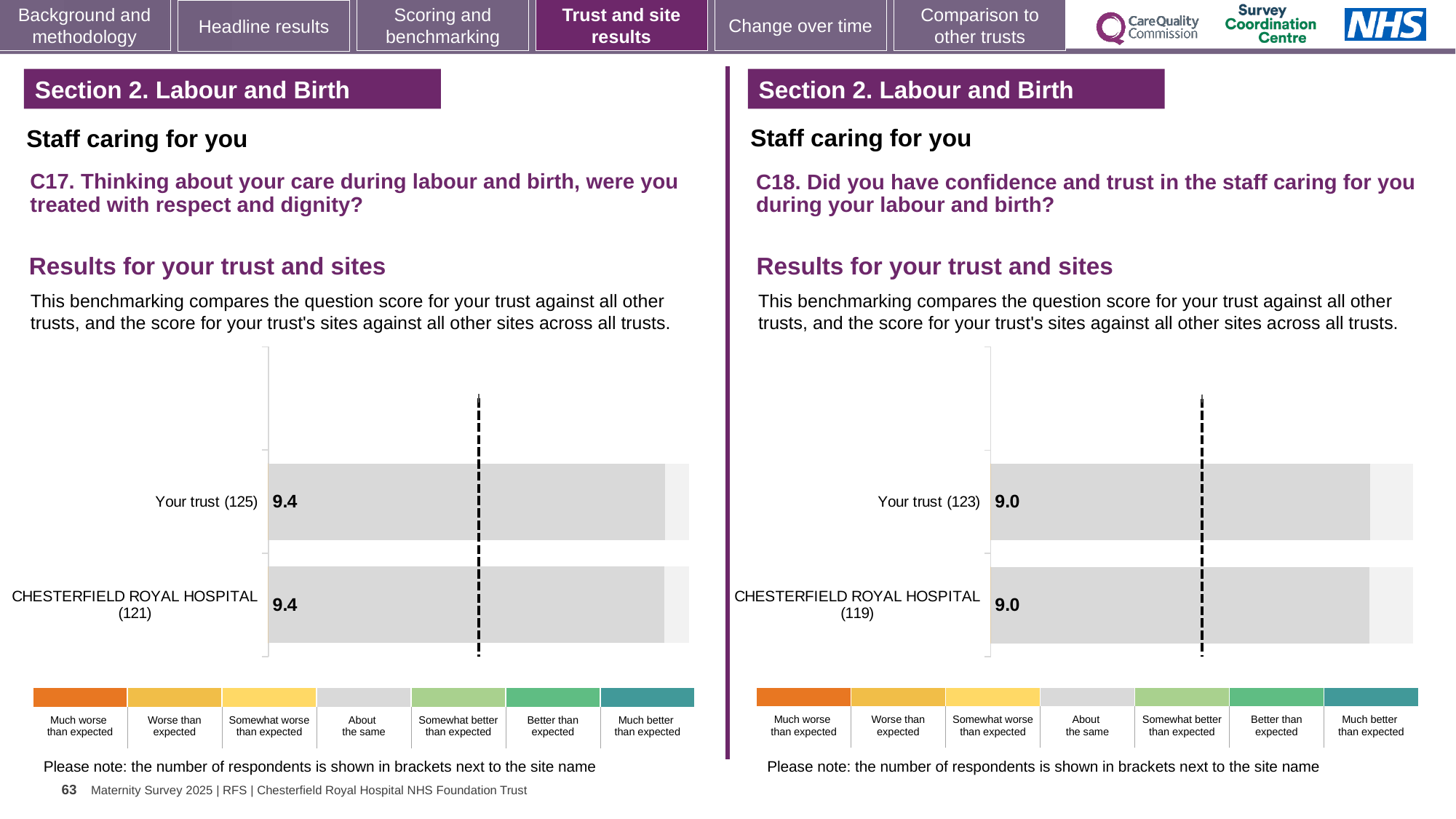
On the C17 chart (left), how many respondents are shown in brackets for CHESTERFIELD ROYAL HOSPITAL? 121 On the C18 chart (right), what is the score for Your trust (123)? 9.0 On the C17 chart (left), what is the score for CHESTERFIELD ROYAL HOSPITAL (121)? 9.4 What kind of chart is used on the C17 chart (left)? Bar chart On the C17 chart (left), what is the difference between the score for Your trust and the score for CHESTERFIELD ROYAL HOSPITAL? 0.0 On the C18 chart (right), what is the difference between the score for Your trust and the score for CHESTERFIELD ROYAL HOSPITAL? 0.0 Is the score for Your trust on the C17 chart (left) larger or smaller than the score for Your trust on the C18 chart (right)? Larger How many bars are plotted on the C17 chart (left)? 2 On the C18 chart (right), what is the score for CHESTERFIELD ROYAL HOSPITAL (119)? 9.0 On the C17 chart (left), what is the score for Your trust (125)? 9.4 How many bars are plotted on the C18 chart (right)? 2 On the C18 chart (right), how many respondents are shown in brackets for Your trust? 123